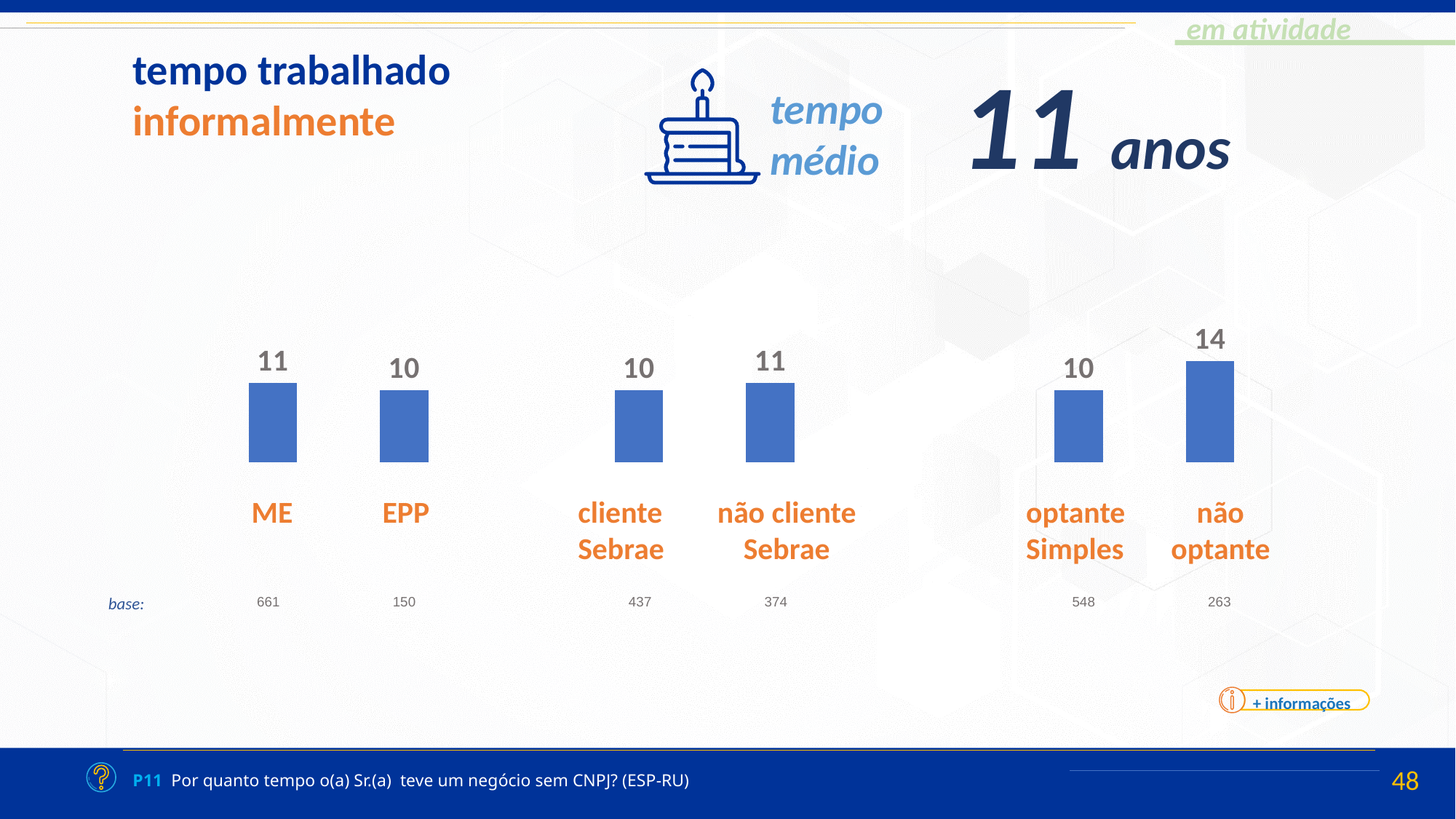
What kind of chart is shown on the slide? bar chart What is the base (number of respondents) shown for cliente Sebrae? 437 What is the value for ME? 11 How many categories are shown in the chart? 6 What is the difference between the values for não cliente Sebrae and cliente Sebrae? 1 Which category has the highest value? não optante What is the value for não cliente Sebrae? 11 What is the difference between the values for não optante and optante Simples? 4 What is the value for não optante? 14 Which is larger, the value for ME or the value for EPP? ME What is the average time (tempo médio) shown on the slide? 11 anos What is the value for EPP? 10